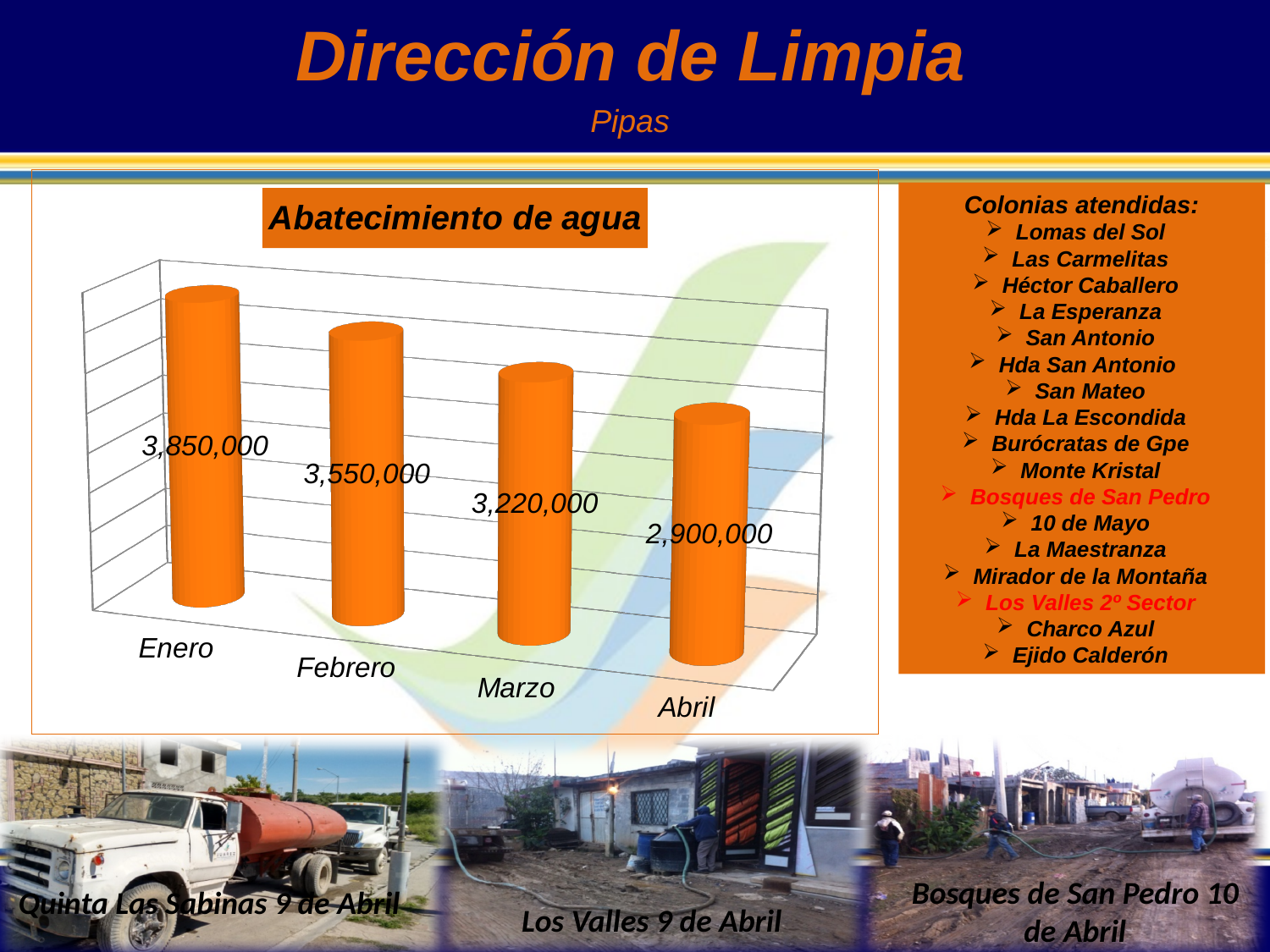
What is the difference between the values for Enero and Abril in the Abatecimiento de agua chart? 950,000 Do the values in the Abatecimiento de agua chart rise or fall from Enero to Abril? Fall What is the value for Marzo in the Abatecimiento de agua chart? 3,220,000 Which is larger in the Abatecimiento de agua chart, the value for Febrero or the value for Marzo? Febrero Which month has the highest value in the Abatecimiento de agua chart? Enero How many months are shown in the Abatecimiento de agua chart? 4 Which month has the lowest value in the Abatecimiento de agua chart? Abril What is the value for Febrero in the Abatecimiento de agua chart? 3,550,000 What is the difference between the values for Febrero and Marzo in the Abatecimiento de agua chart? 330,000 What is the value for Enero in the Abatecimiento de agua chart? 3,850,000 What kind of chart is the Abatecimiento de agua chart? Bar chart What is the value for Abril in the Abatecimiento de agua chart? 2,900,000